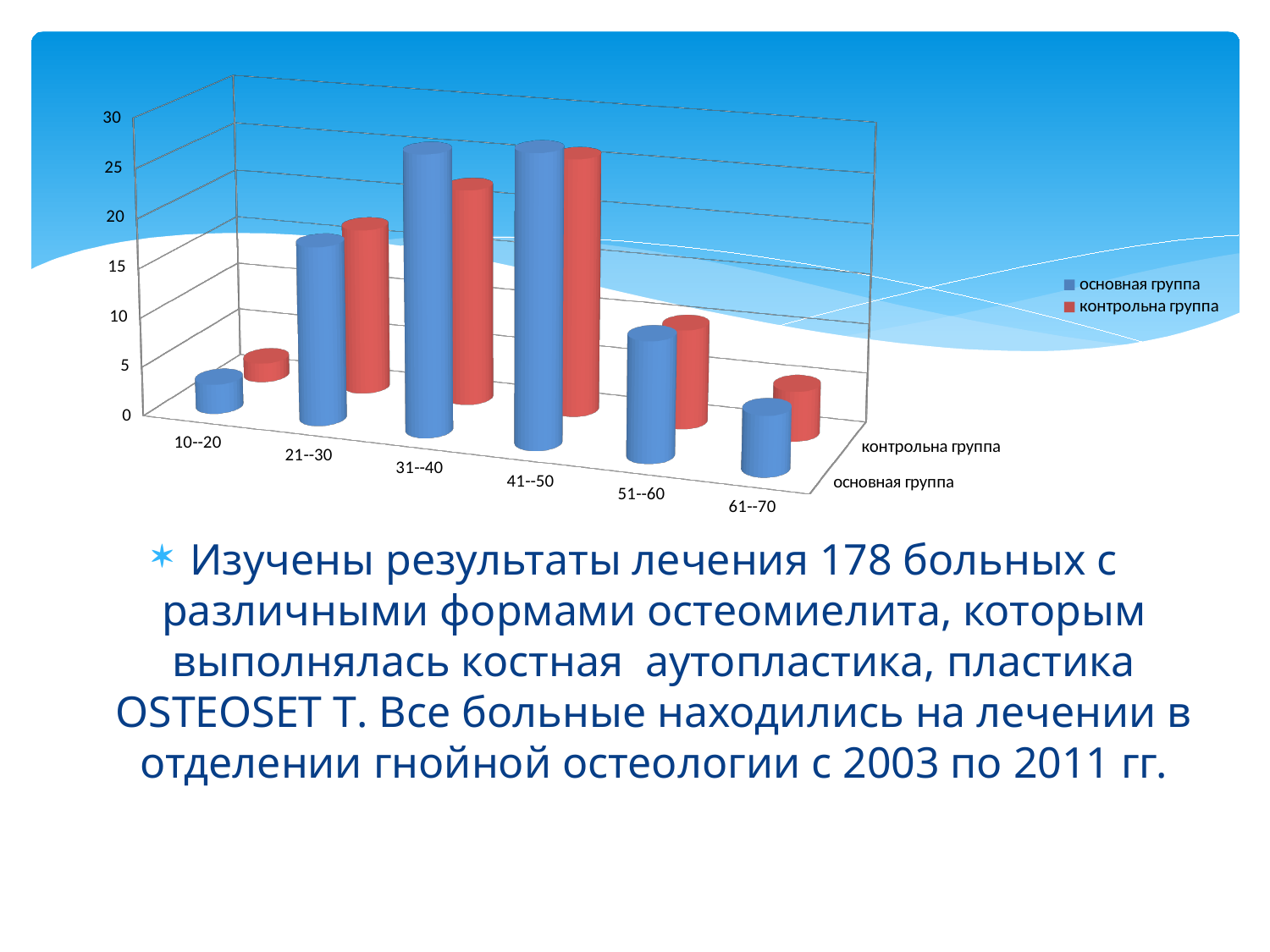
What kind of chart is shown on the slide? bar chart Is the value for 51--60 in the основная группа series greater or less than 15? less Is the value for 31--40 in the основная группа series greater or less than 20? greater Is the value for 10--20 in the основная группа series greater or less than 10? less Which series is shown in red in the chart? контрольна группа How many series does the chart legend list? 2 How many age-group categories are shown on the x axis of the chart? 6 In the основная группа series, which is larger: the value for 31--40 or the value for 51--60? 31--40 In the основная группа series, do the values rise or fall from 41--50 to 61--70? fall